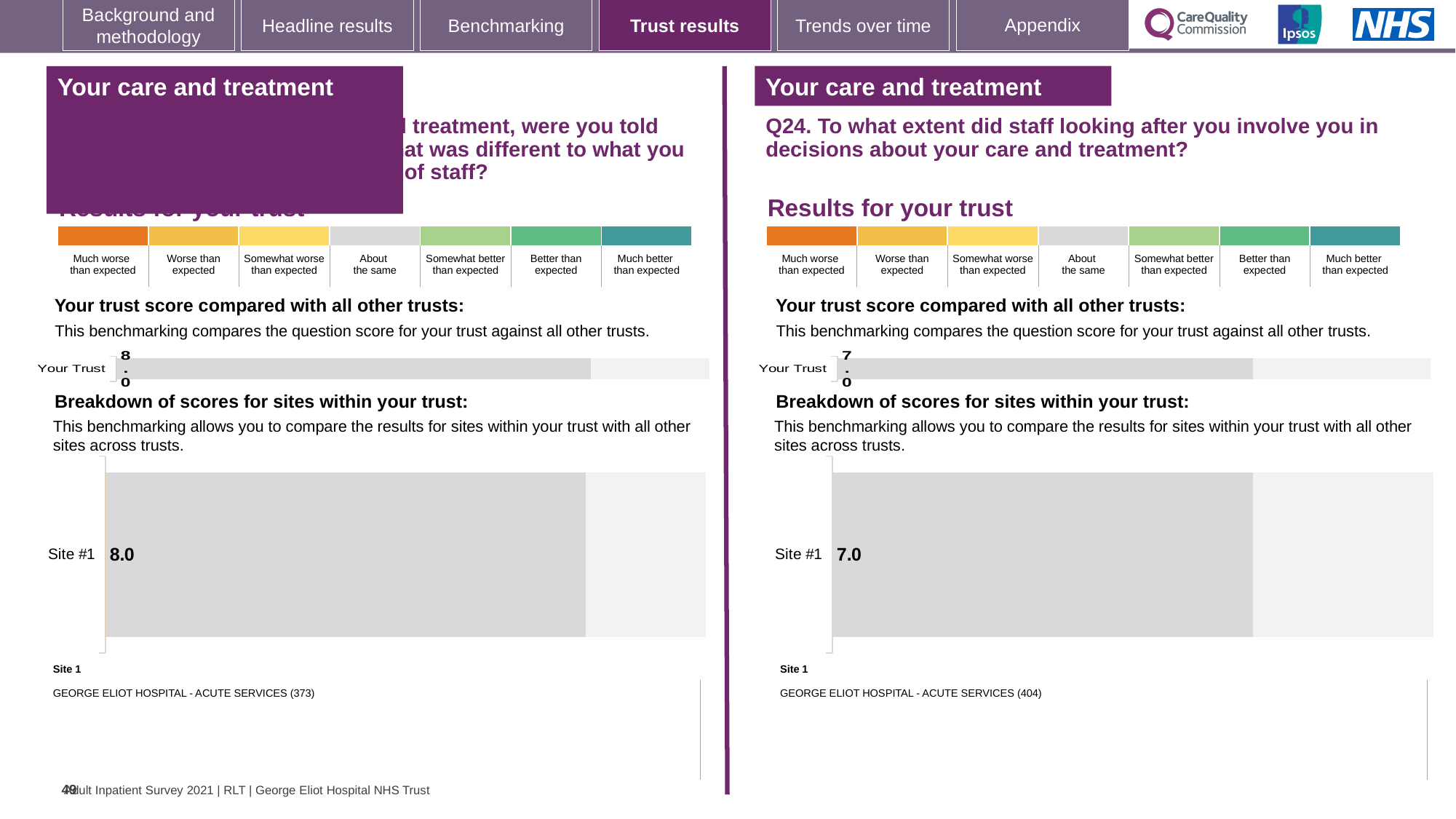
On the left-hand panel, which site name is listed as Site 1? GEORGE ELIOT HOSPITAL - ACUTE SERVICES (373) What kind of chart is used to show the Site #1 score on the left-hand panel? Bar chart On the left-hand panel, what is the score shown for Site #1? 8.0 On the right-hand panel (Q24), what is the score shown for Site #1? 7.0 How many sites are shown in the site breakdown chart on the right-hand panel (Q24)? 1 What is the difference between the Your Trust score on the left-hand panel and the Your Trust score on the right-hand panel (Q24)? 1.0 On the right-hand panel (Q24), which site name is listed as Site 1? GEORGE ELIOT HOSPITAL - ACUTE SERVICES (404) What is the difference between the Site #1 score on the left-hand panel and the Site #1 score on the right-hand panel (Q24)? 1.0 Which is larger: the Site #1 score on the left-hand panel or the Site #1 score on the right-hand panel (Q24)? Left-hand panel On the right-hand panel (Q24), what is the score shown for Your Trust? 7.0 On the left-hand panel, what is the score shown for Your Trust? 8.0